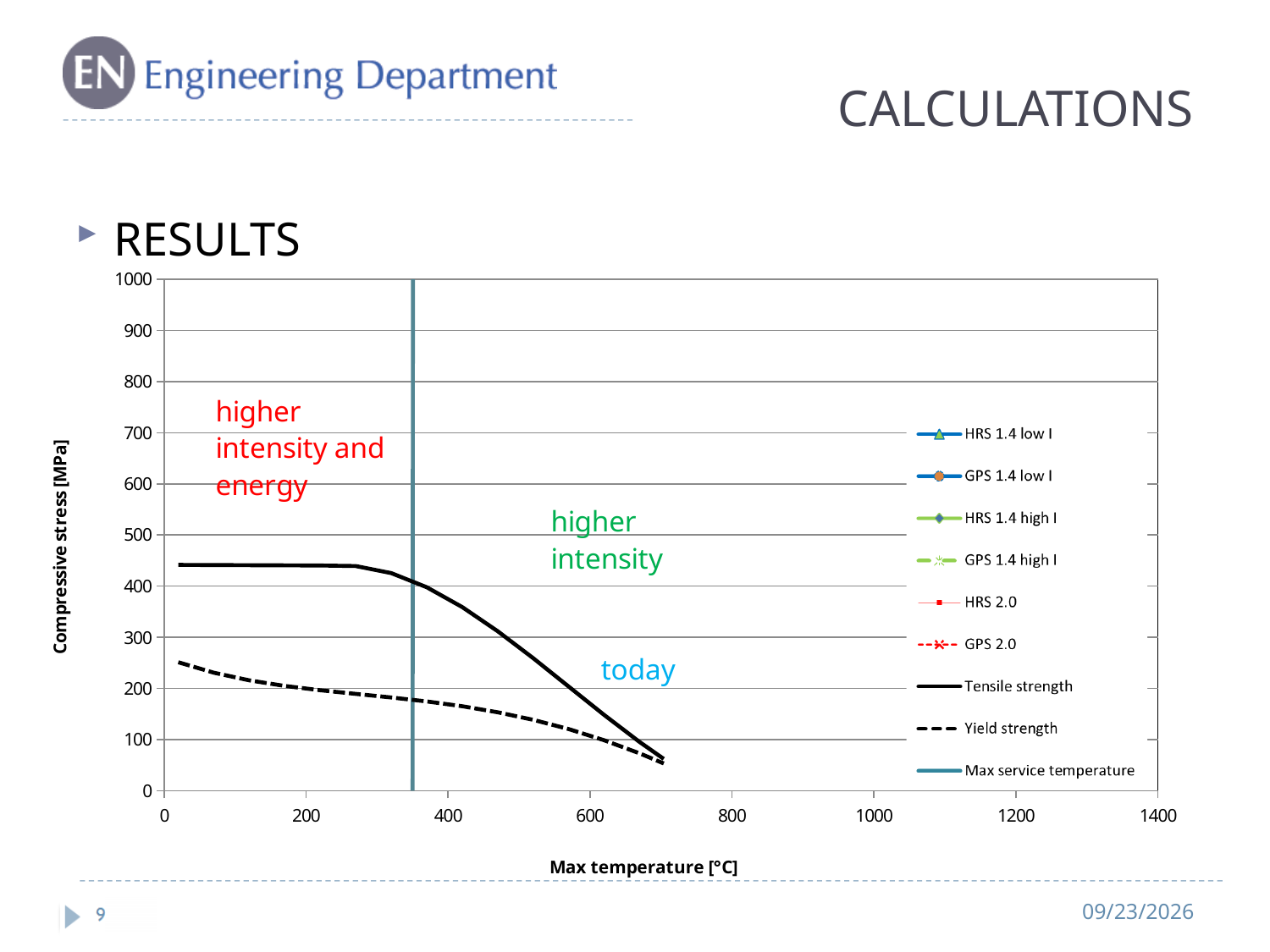
Is the Max service temperature line positioned at a temperature greater or less than 400 °C? less At 200 °C, which is larger: Tensile strength or Yield strength? Tensile strength How many series does the chart legend list? 9 Is the Tensile strength value at 200 °C greater or less than 400 MPa? greater What is the label of the x axis of the chart? Max temperature [°C] What is the highest value shown on the y axis of the chart? 1000 Does the Tensile strength curve rise or fall as Max temperature increases from 400 to 700 °C? fall Is the Yield strength value at 0 °C greater or less than 200 MPa? greater What is the label of the y axis of the chart? Compressive stress [MPa] Does the Yield strength curve rise or fall as Max temperature increases along the x axis? fall What kind of chart is shown on the slide? line chart